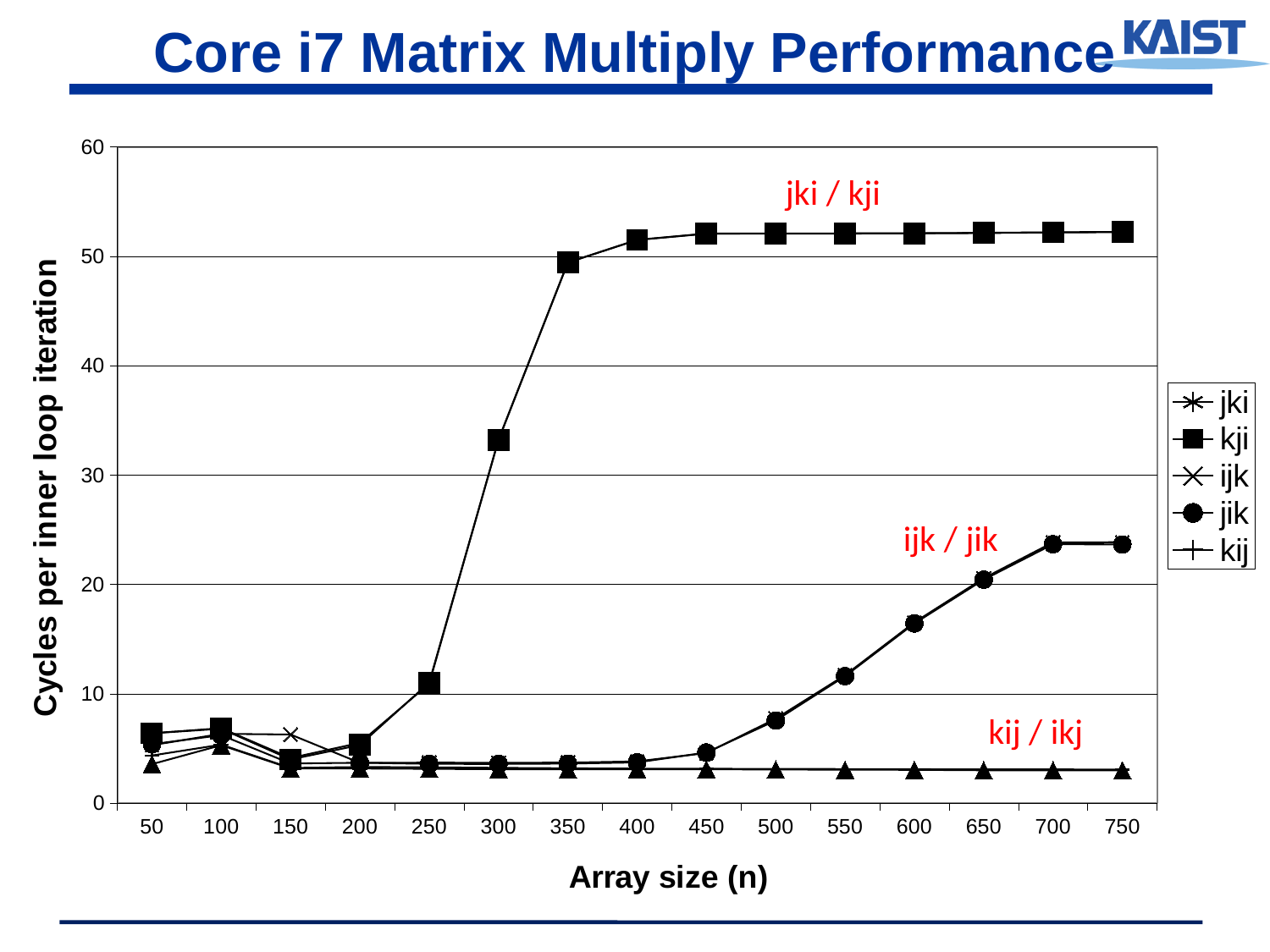
Is the value for kji at array size 250 greater or less than 20? less Is the value for kji at array size 750 greater or less than 50? greater How many series does the legend list? 5 Which series has the highest value at array size 750? kji Is the value for jik at array size 750 greater or less than 20? greater What kind of chart is shown on the slide? line chart At array size 300, which is larger, the value for kji or the value for jik? kji How many array size values are marked along the x axis? 15 Does the kji series rise or fall as the array size goes from 200 to 400? rise What is the title of the y axis? Cycles per inner loop iteration